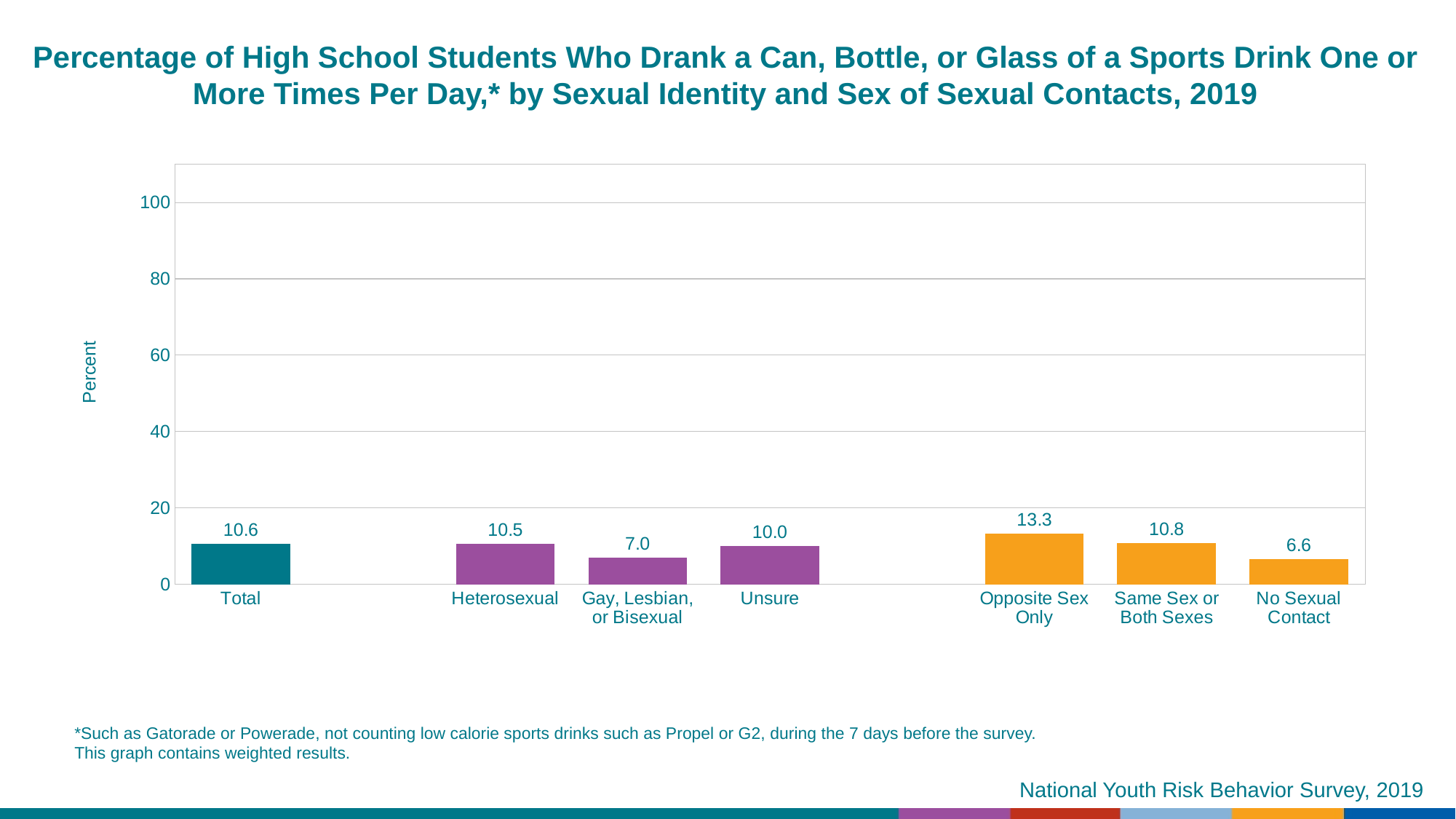
What is the value for Gay, Lesbian, or Bisexual students? 7.0 Which category has the lowest value? No Sexual Contact What is the value for students with No Sexual Contact? 6.6 What is the value for Total? 10.6 How many categories are shown on the x axis? 7 Which is larger, the value for Unsure or the value for Gay, Lesbian, or Bisexual? Unsure What is the difference between the values for Heterosexual and Gay, Lesbian, or Bisexual? 3.5 What kind of chart is shown on the slide? Bar chart What percentage of Heterosexual students drank a sports drink one or more times per day? 10.5 What is the difference between the values for Opposite Sex Only and Same Sex or Both Sexes? 2.5 Is the value for Opposite Sex Only greater or less than 20? less Which category has the highest value? Opposite Sex Only